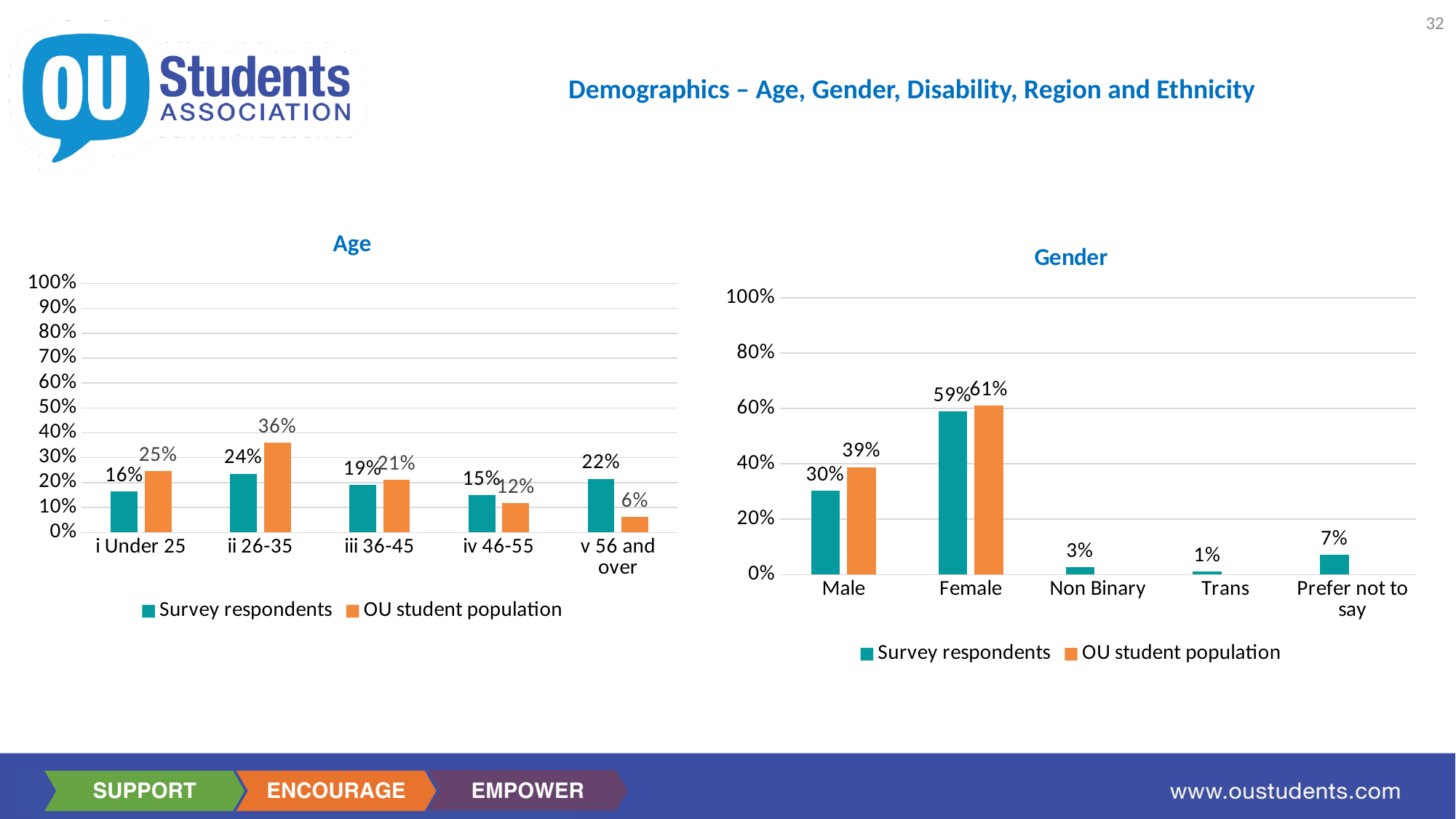
In the Age chart, how many age groups are shown on the x axis? 5 How many series does the legend of the Gender chart list? 2 In the Age chart, what percentage of survey respondents are in the ii 26-35 group? 24% In the Gender chart, what is the difference between the OU student population and survey respondents values for Male? 9% In the Age chart, what is the difference between the OU student population and survey respondents values for ii 26-35? 12% What type of chart is the Age chart? Bar chart In the Age chart, which is larger for v 56 and over: survey respondents or OU student population? Survey respondents In the Gender chart, what percentage of survey respondents are Female? 59% In the Age chart, which age group has the highest OU student population value? ii 26-35 In the Gender chart, what is the OU student population value for Male? 39% In the Age chart, what is the OU student population value for v 56 and over? 6% In the Gender chart, which gender category has the lowest survey respondents value? Trans